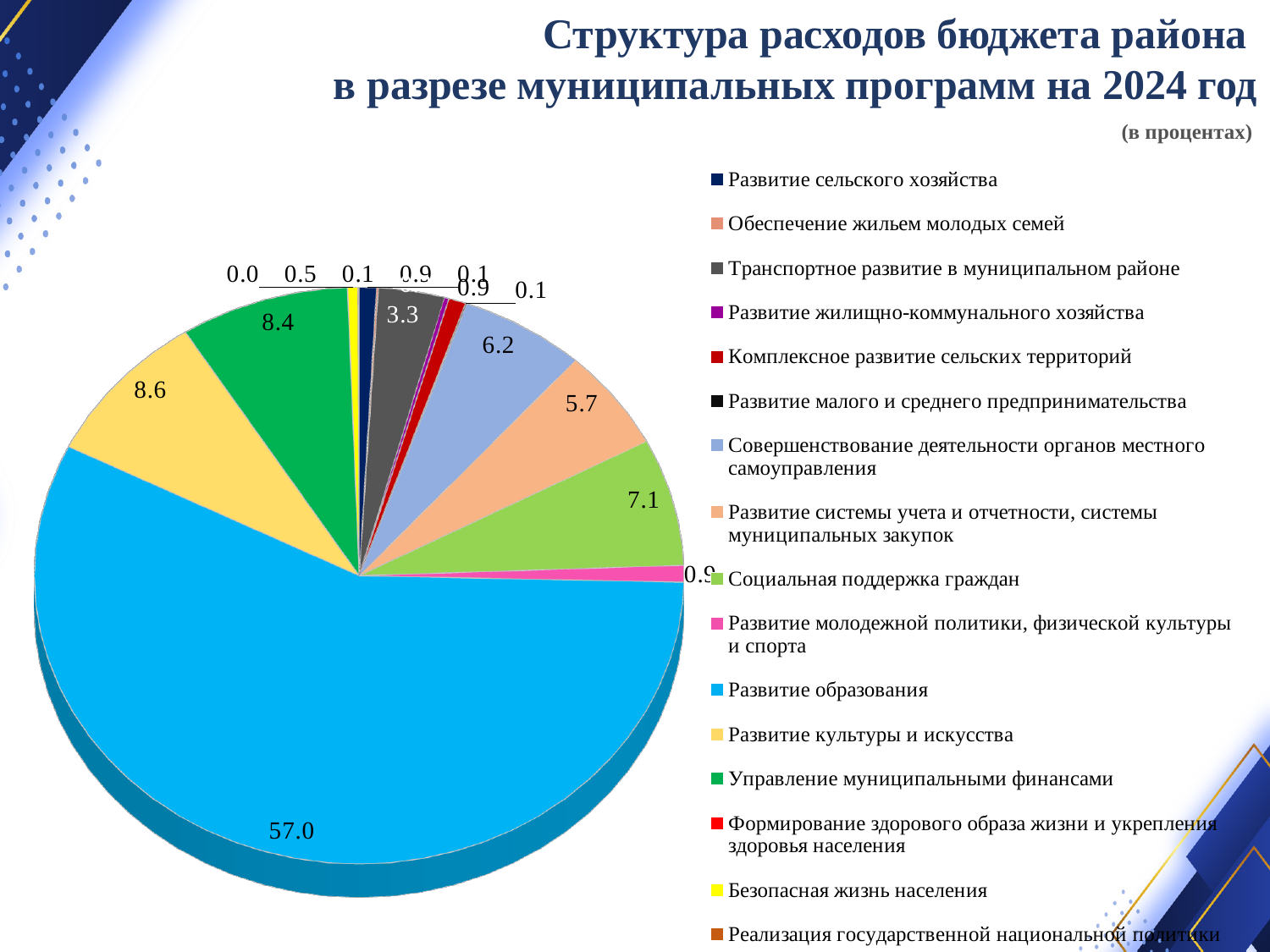
What is the value for Социальная поддержка граждан? 7.1 What unit is stated under the chart title? в процентах What is the difference between the values for Развитие культуры и искусства and Управление муниципальными финансами? 0.2 What is the value for Развитие культуры и искусства? 8.6 What is the value for Совершенствование деятельности органов местного самоуправления? 6.2 What is the value for Управление муниципальными финансами? 8.4 What is the value for Развитие образования? 57.0 What is the value for Транспортное развитие в муниципальном районе? 3.3 How many categories does the legend list? 16 Which category has the largest share of the pie? Развитие образования Which is larger: Социальная поддержка граждан or Развитие системы учета и отчетности, системы муниципальных закупок? Социальная поддержка граждан What kind of chart is shown on the slide? pie chart